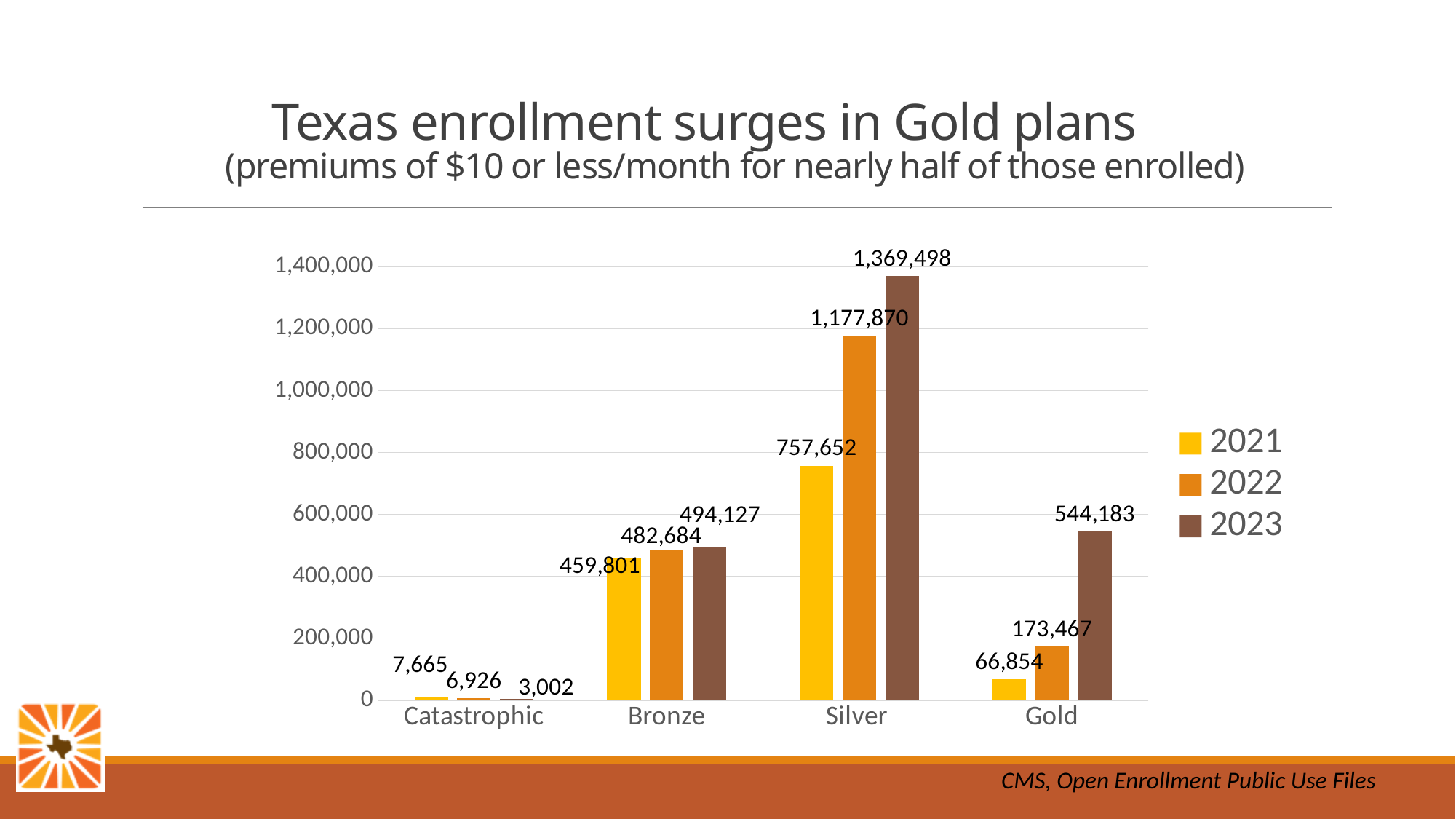
How many series does the legend list? 3 What is the 2022 enrollment value for Bronze plans? 482,684 What kind of chart is shown on the slide? Bar chart Which is larger: the 2022 value for Bronze or the 2022 value for Gold? 2022 value for Bronze What is the 2023 enrollment value for Gold plans? 544,183 How many plan categories are shown on the x axis? 4 Which plan category has the highest enrollment in 2023? Silver What is the 2023 enrollment value for Catastrophic plans? 3,002 What is the difference between the 2023 and 2021 enrollment values for Silver plans? 611,846 What is the difference between the 2023 and 2022 enrollment values for Gold plans? 370,716 What is the 2021 enrollment value for Silver plans? 757,652 Which plan category has the lowest enrollment in 2021? Catastrophic